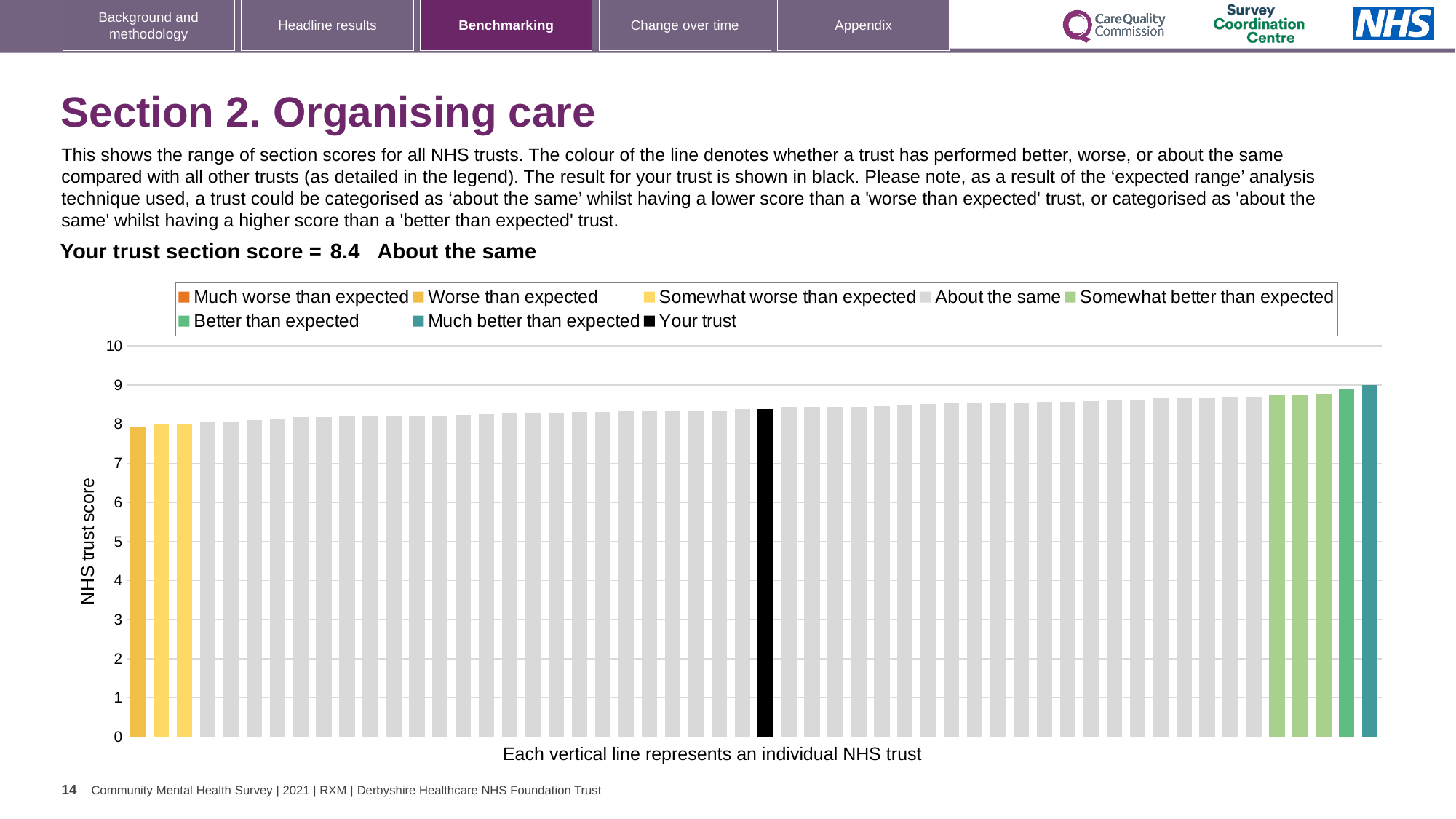
Which legend category does the tallest bar belong to? Much better than expected How many entries does the chart legend list? 8 Is the value for your trust (the black bar) greater or less than 8? greater Is the value of the leftmost bar greater or less than 9? less Do the bar values rise or fall from left to right along the x axis? rise What is the label on the y axis of the chart? NHS trust score What is the section score for your trust shown on the slide? 8.4 Is the value of the tallest bar greater or less than 8? greater Which is larger: the black 'Your trust' bar or the leftmost bar? Your trust Which is larger: the rightmost bar or the black 'Your trust' bar? the rightmost bar What kind of chart is shown on the slide? bar chart What colour is used for the 'Your trust' bar? black